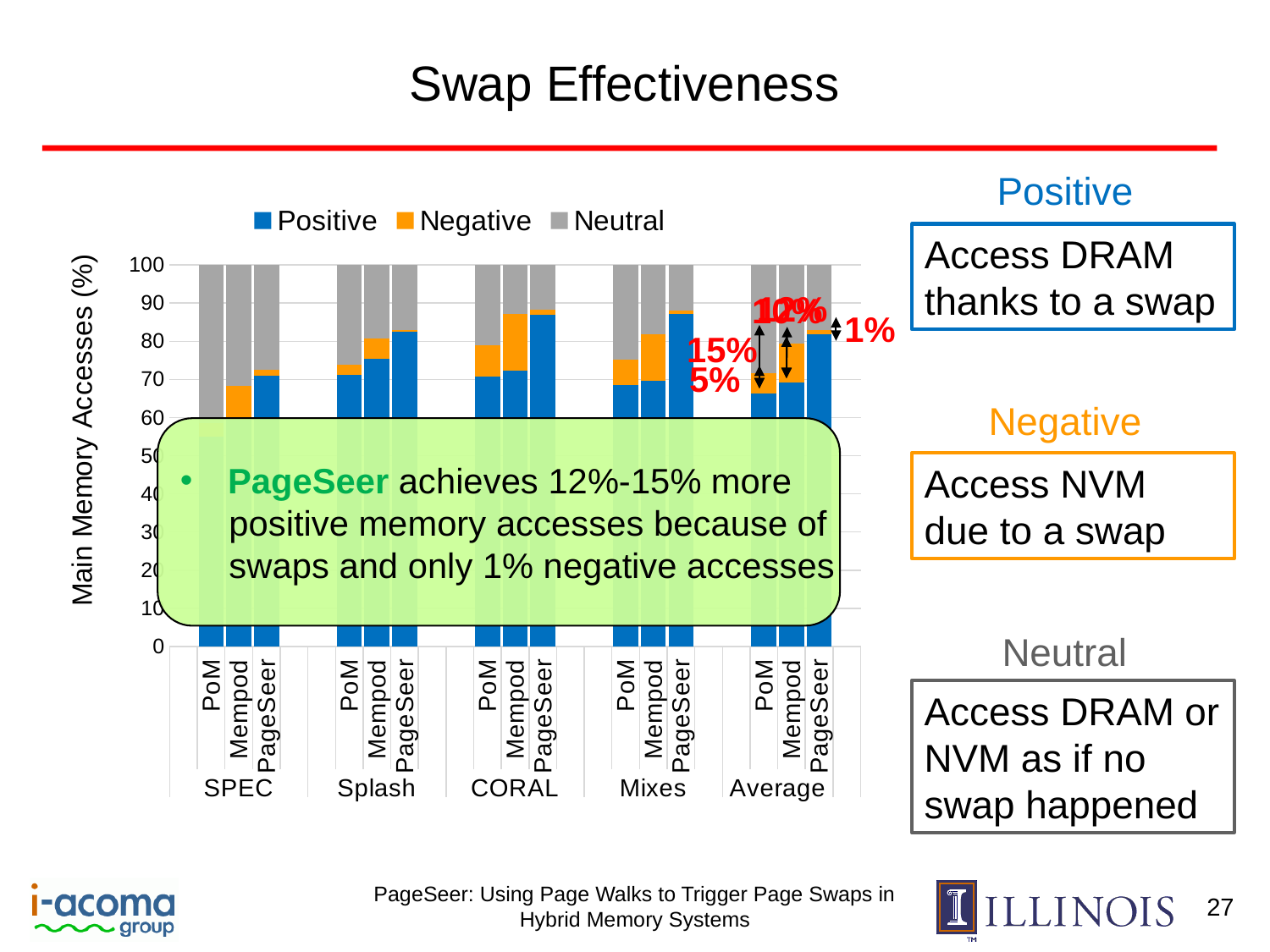
Which series are listed in the legend? Positive, Negative, Neutral Is the Positive value for PoM in the Average group greater or less than 70? less How many series does the legend list? 3 What kind of chart is shown on the slide? stacked bar chart Is the Positive value for PoM in the Splash group greater or less than 60? greater In the CORAL group, which has the larger Positive value, PoM or PageSeer? PageSeer How many benchmark groups are shown along the x axis? 5 How many bars are plotted in total? 15 What is the label of the y axis? Main Memory Accesses (%) What is the total height of the PoM stacked bar in the SPEC group? 100 In the Average group, which system has the highest Positive value? PageSeer Is the Positive value for PageSeer in the CORAL group greater or less than 80? greater